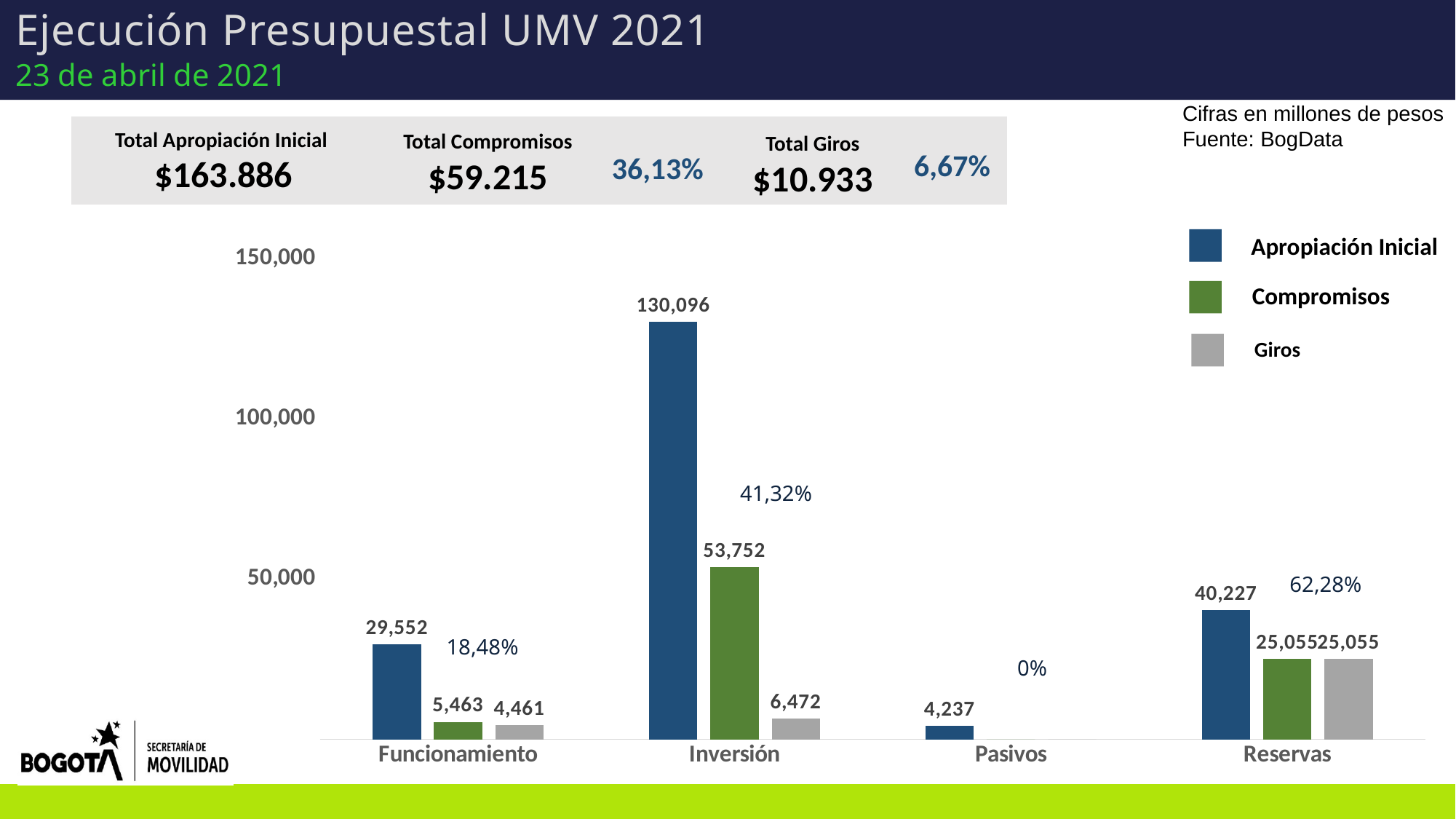
What is the Apropiación Inicial value for Inversión? 130,096 What is the difference between the Apropiación Inicial and Compromisos values for Inversión? 76,344 What is the Apropiación Inicial value for Pasivos? 4,237 Which category has the highest Apropiación Inicial value? Inversión Which is larger, the Giros value for Inversión or the Giros value for Funcionamiento? Giros for Inversión What is the Compromisos value for Funcionamiento? 5,463 How many series does the chart legend list? 3 What percentage label is shown above the Reservas group? 62,28% What is the Giros value for Reservas? 25,055 How many categories are shown on the x axis of the chart? 4 Which category has the lowest Apropiación Inicial value? Pasivos What kind of chart is shown on the slide? bar chart